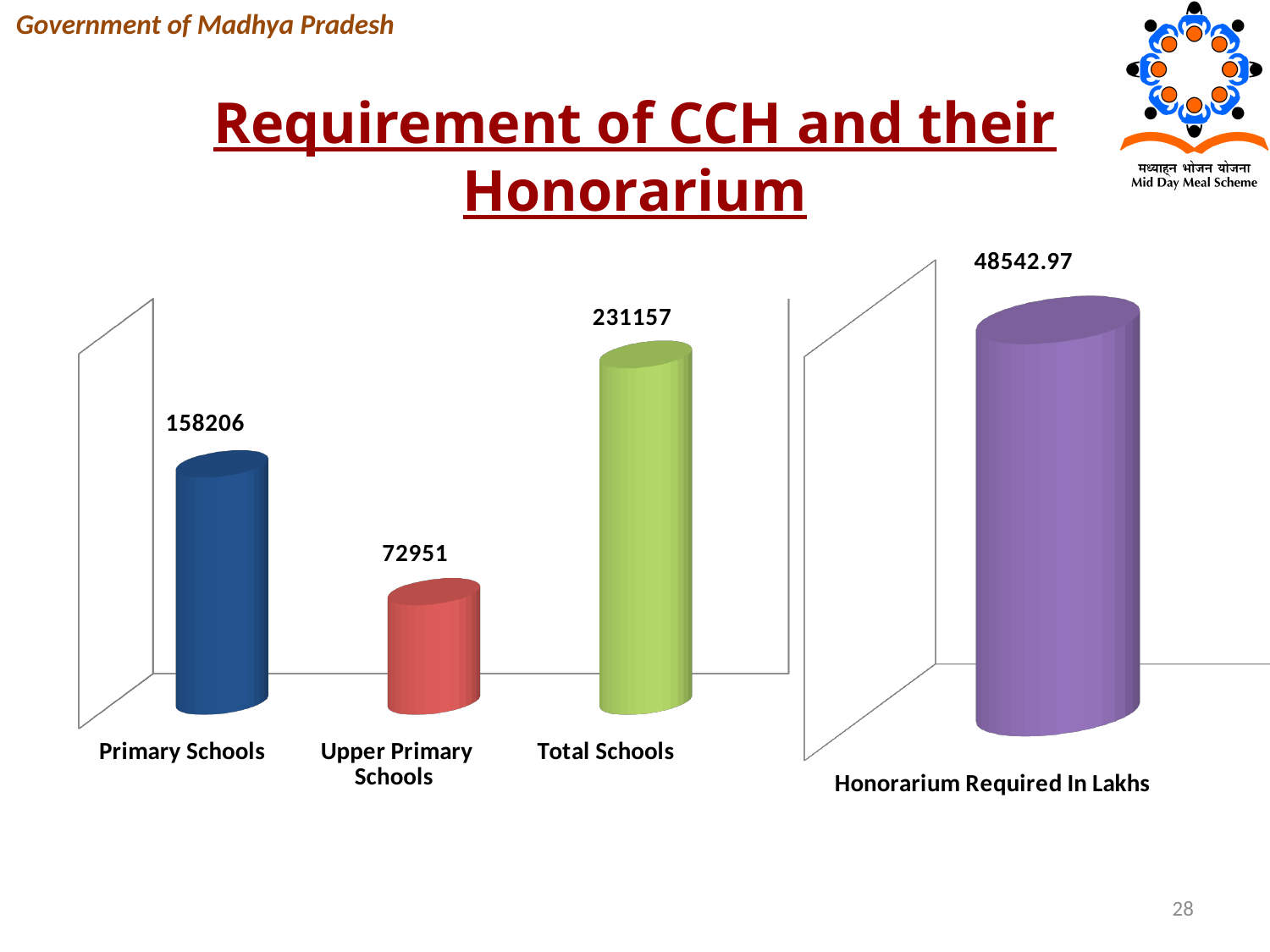
How many bars are shown in the right chart? 1 How many categories are shown in the left chart? 3 In the left chart, which category has the lowest value? Upper Primary Schools In the left chart, what is the difference between the values for Total Schools and Primary Schools? 72951 In the left chart, which is larger, the value for Primary Schools or the value for Upper Primary Schools? Primary Schools In the left chart, what is the value for Total Schools? 231157 In the left chart, which category has the highest value? Total Schools In the left chart, what is the value for Upper Primary Schools? 72951 In the left chart, what is the value for Primary Schools? 158206 In the left chart, what is the difference between the values for Primary Schools and Upper Primary Schools? 85255 What kind of chart is the left chart? Bar chart In the right chart, what is the value for Honorarium Required In Lakhs? 48542.97